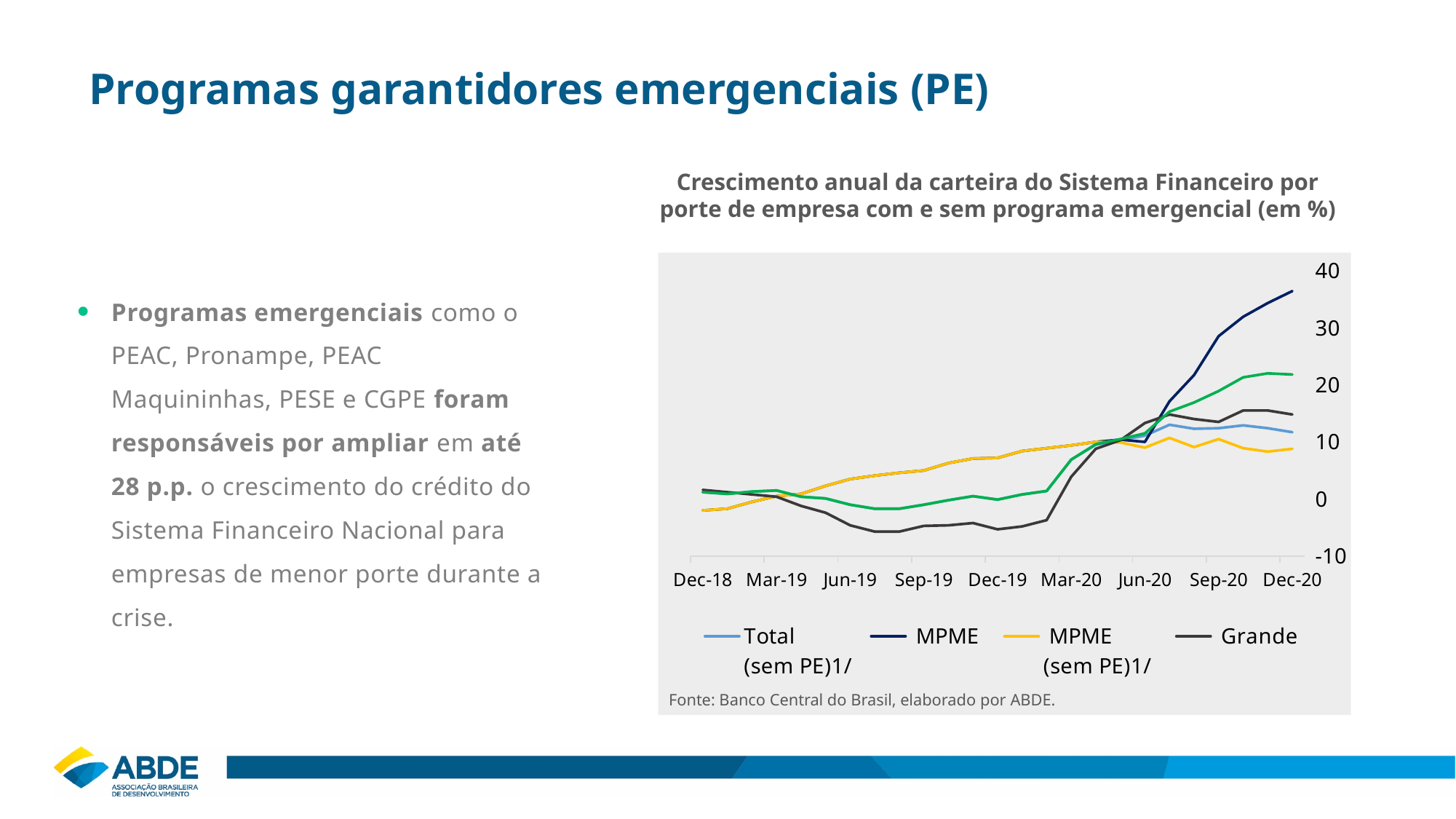
What kind of chart is shown on the slide? line chart Is the value for MPME at Dec-20 greater or less than 30? greater At Dec-20, which is larger: MPME or Grande? MPME Which series has the highest value at Dec-20? MPME Is the value for Grande at Jun-19 greater or less than 0? less Is the value for MPME (sem PE)1/ at Dec-20 greater or less than 10? less How many series does the legend of the chart list? 4 Does the Grande series rise or fall between Dec-18 and Jun-19? fall Does the MPME series rise or fall between Mar-20 and Dec-20? rise Which series has the lowest value at Dec-20? MPME (sem PE)1/ How many date labels are shown on the x axis of the chart? 9 What source is cited below the chart? Banco Central do Brasil, elaborado por ABDE.